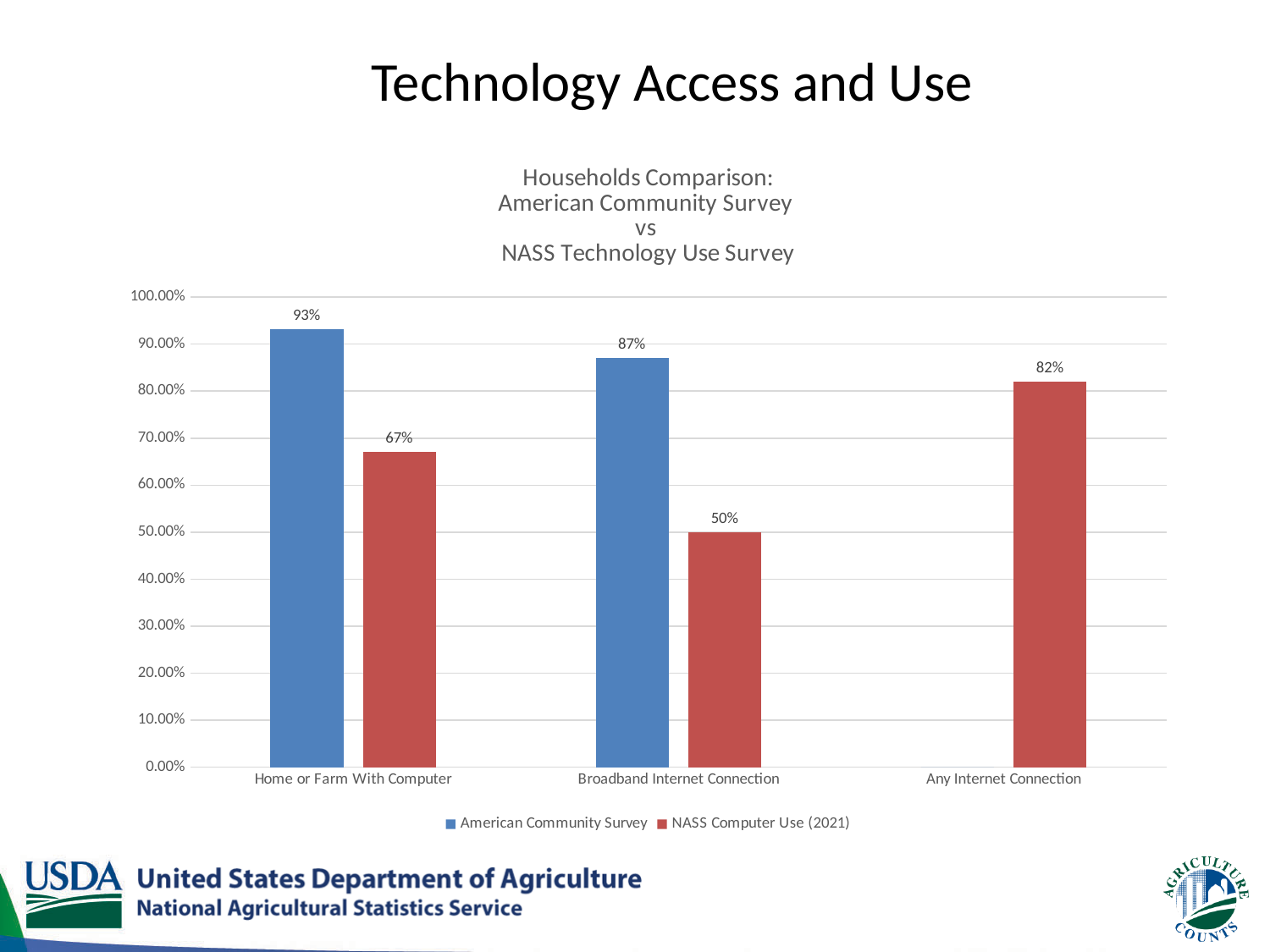
What is the American Community Survey value for Broadband Internet Connection? 87% How many series does the legend list? 2 Which category has the highest American Community Survey value? Home or Farm With Computer What is the NASS Computer Use (2021) value for Any Internet Connection? 82% Which colour represents the NASS Computer Use (2021) series? Red Which is larger for Home or Farm With Computer: the American Community Survey value or the NASS Computer Use (2021) value? American Community Survey What is the difference between the American Community Survey and NASS Computer Use (2021) values for Broadband Internet Connection? 37% What kind of chart is shown on the slide? Bar chart What is the NASS Computer Use (2021) value for Broadband Internet Connection? 50% How many categories are shown on the x axis? 3 Which category has the lowest NASS Computer Use (2021) value? Broadband Internet Connection What is the American Community Survey value for Home or Farm With Computer? 93%